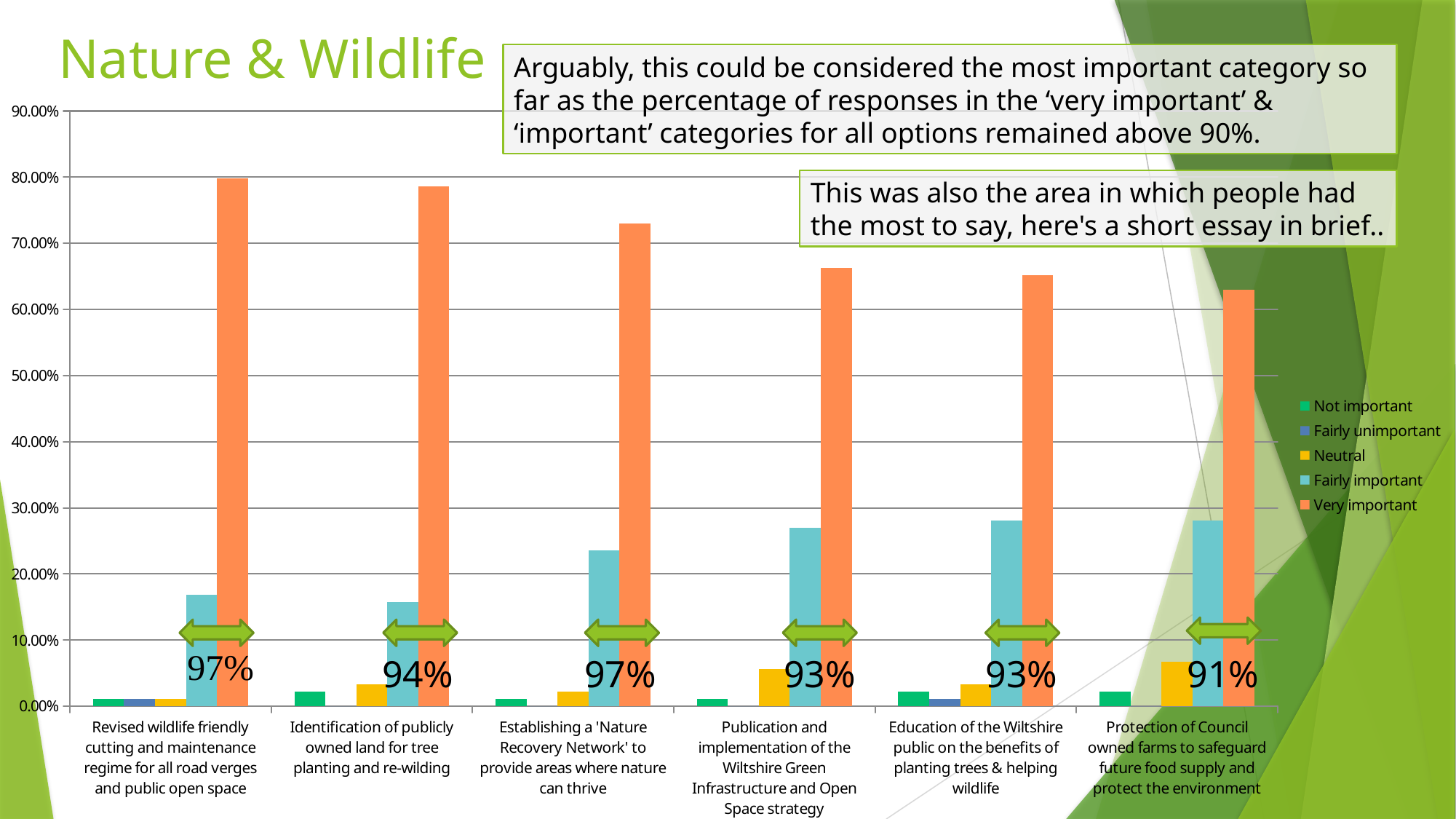
Do the 'Very important' values rise or fall moving from left to right across the categories? Fall What combined percentage is labelled for 'Protection of Council owned farms to safeguard future food supply and protect the environment'? 91% Is the 'Very important' value for 'Revised wildlife friendly cutting and maintenance regime for all road verges and public open space' greater or less than 70.00%? greater What combined percentage is labelled for 'Revised wildlife friendly cutting and maintenance regime for all road verges and public open space'? 97% How many series does the legend list? 5 Which category has the lowest combined percentage label? Protection of Council owned farms to safeguard future food supply and protect the environment What kind of chart is shown on the slide? Bar chart What combined percentage is labelled for 'Identification of publicly owned land for tree planting and re-wilding'? 94% Which has the larger 'Very important' value: 'Revised wildlife friendly cutting and maintenance regime' or 'Protection of Council owned farms'? Revised wildlife friendly cutting and maintenance regime How many categories are shown along the x axis? 6 Is the 'Very important' value for 'Protection of Council owned farms to safeguard future food supply and protect the environment' greater or less than 70.00%? less What is the difference between the combined percentage labels for 'Revised wildlife friendly cutting and maintenance regime' and 'Protection of Council owned farms'? 6 percentage points